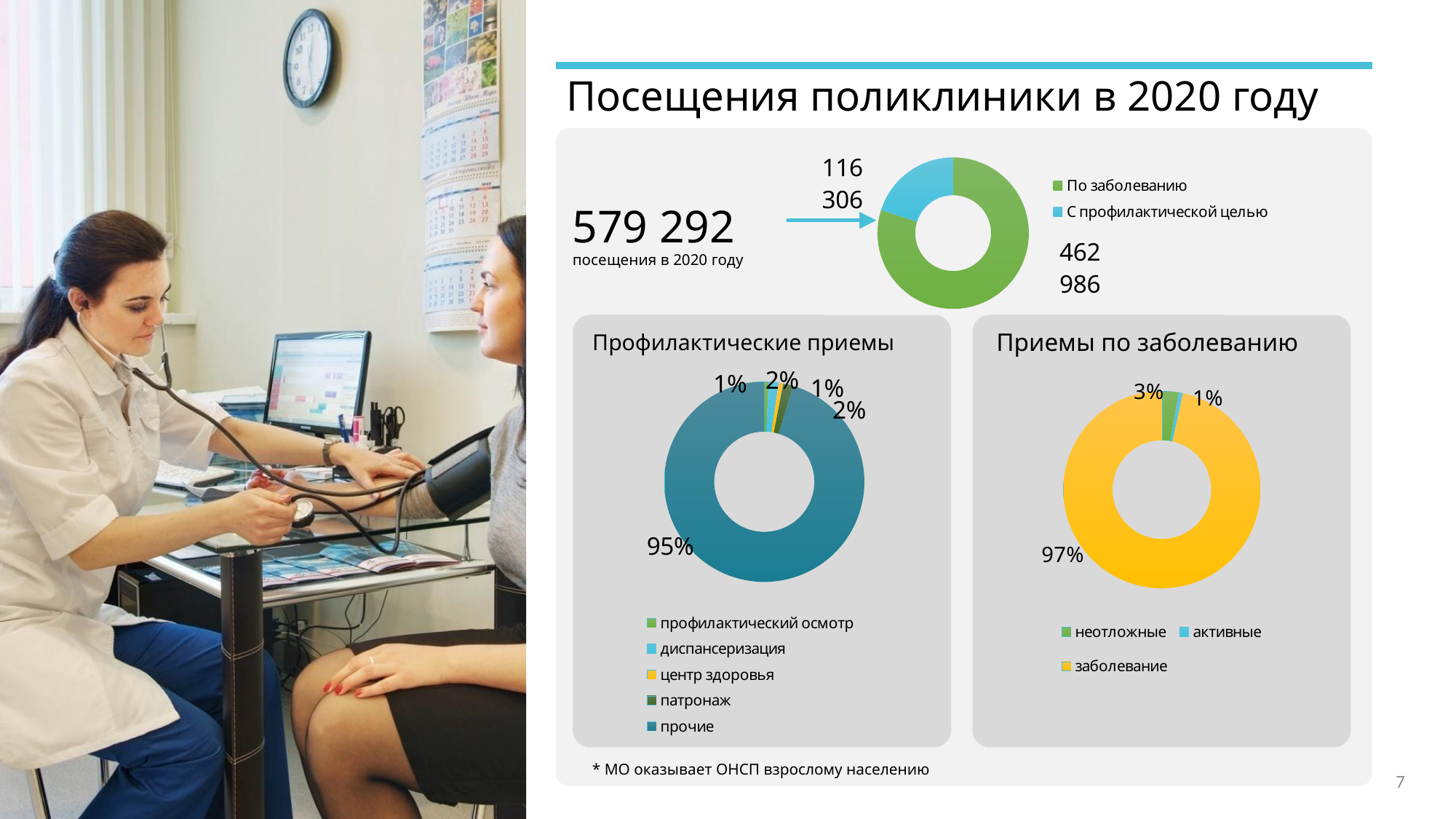
In the 'Профилактические приемы' chart, which category has the largest share? прочие In the 'Приемы по заболеванию' chart, what share does 'заболевание' have? 97% In the top donut chart, what is the total of the two categories? 579 292 In the top donut chart, what is the value for 'С профилактической целью'? 116 306 In the top donut chart, what is the difference between 'По заболеванию' and 'С профилактической целью'? 346 680 In the 'Приемы по заболеванию' chart, which category is the smallest? активные How many categories does the legend of the 'Профилактические приемы' chart list? 5 In the 'Приемы по заболеванию' chart, what share does 'неотложные' have? 3% In the top donut chart, what is the value for 'По заболеванию'? 462 986 How many categories does the legend of the top donut chart list? 2 In the top donut chart, which category has the larger value? По заболеванию In the 'Приемы по заболеванию' chart, what share does 'активные' have? 1%